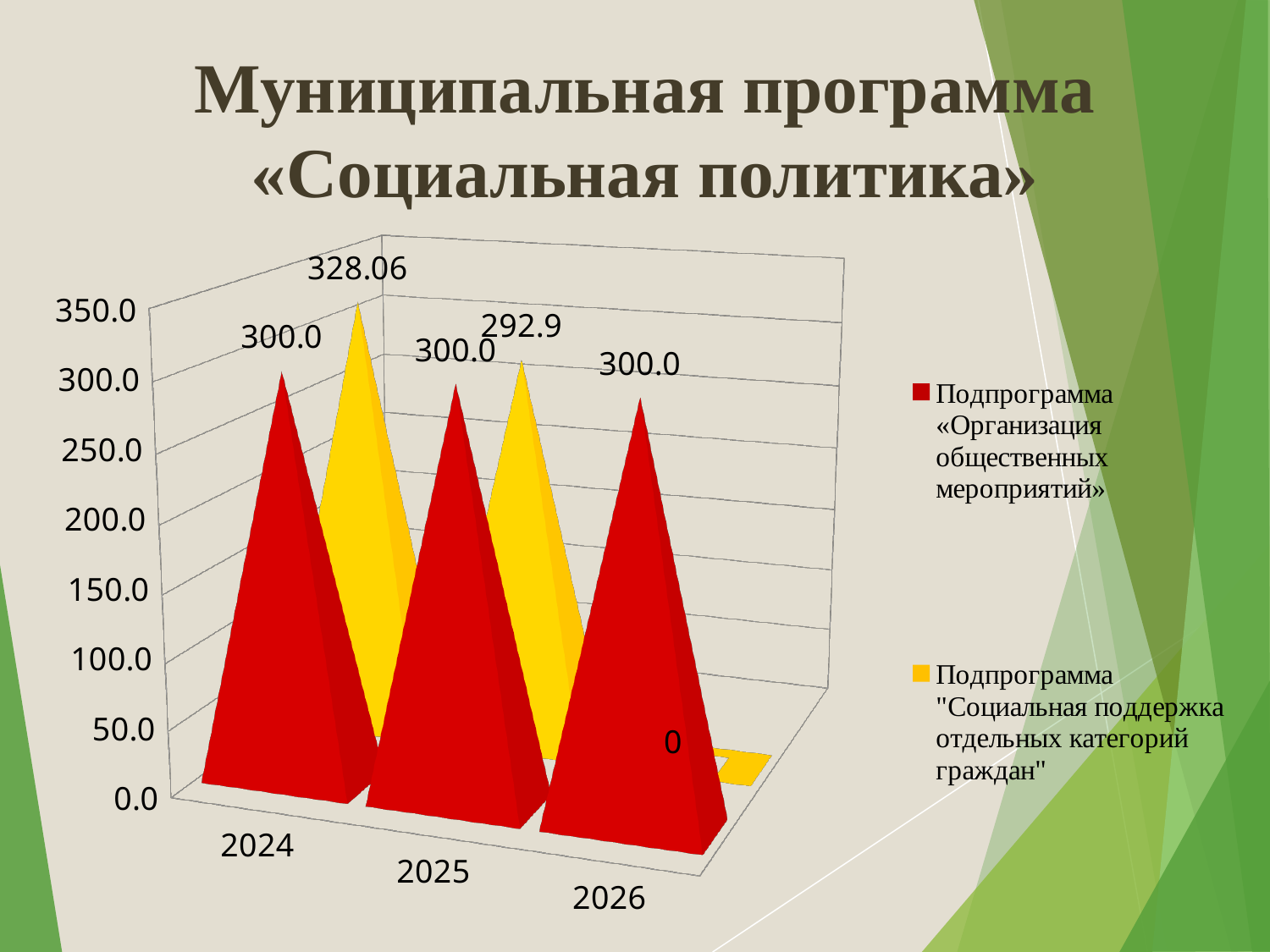
What is the value for the yellow series "Социальная поддержка отдельных категорий граждан" in 2024? 328.06 How many series does the legend list? 2 What is the value for the red series «Организация общественных мероприятий» in 2024? 300.0 What is the value for the yellow series "Социальная поддержка отдельных категорий граждан" in 2025? 292.9 What is the difference between the yellow series values for 2024 and 2025? 35.16 What kind of chart is shown on the slide? bar chart What is the value for the yellow series "Социальная поддержка отдельных категорий граждан" in 2026? 0 In which year is the yellow series "Социальная поддержка отдельных категорий граждан" highest? 2024 In which year is the yellow series "Социальная поддержка отдельных категорий граждан" lowest? 2026 How many years are shown on the x axis of the chart? 3 Does the yellow series "Социальная поддержка отдельных категорий граждан" rise or fall from 2024 to 2026? fall In 2025, which series has the larger value, the red «Организация общественных мероприятий» or the yellow "Социальная поддержка отдельных категорий граждан"? Подпрограмма «Организация общественных мероприятий»